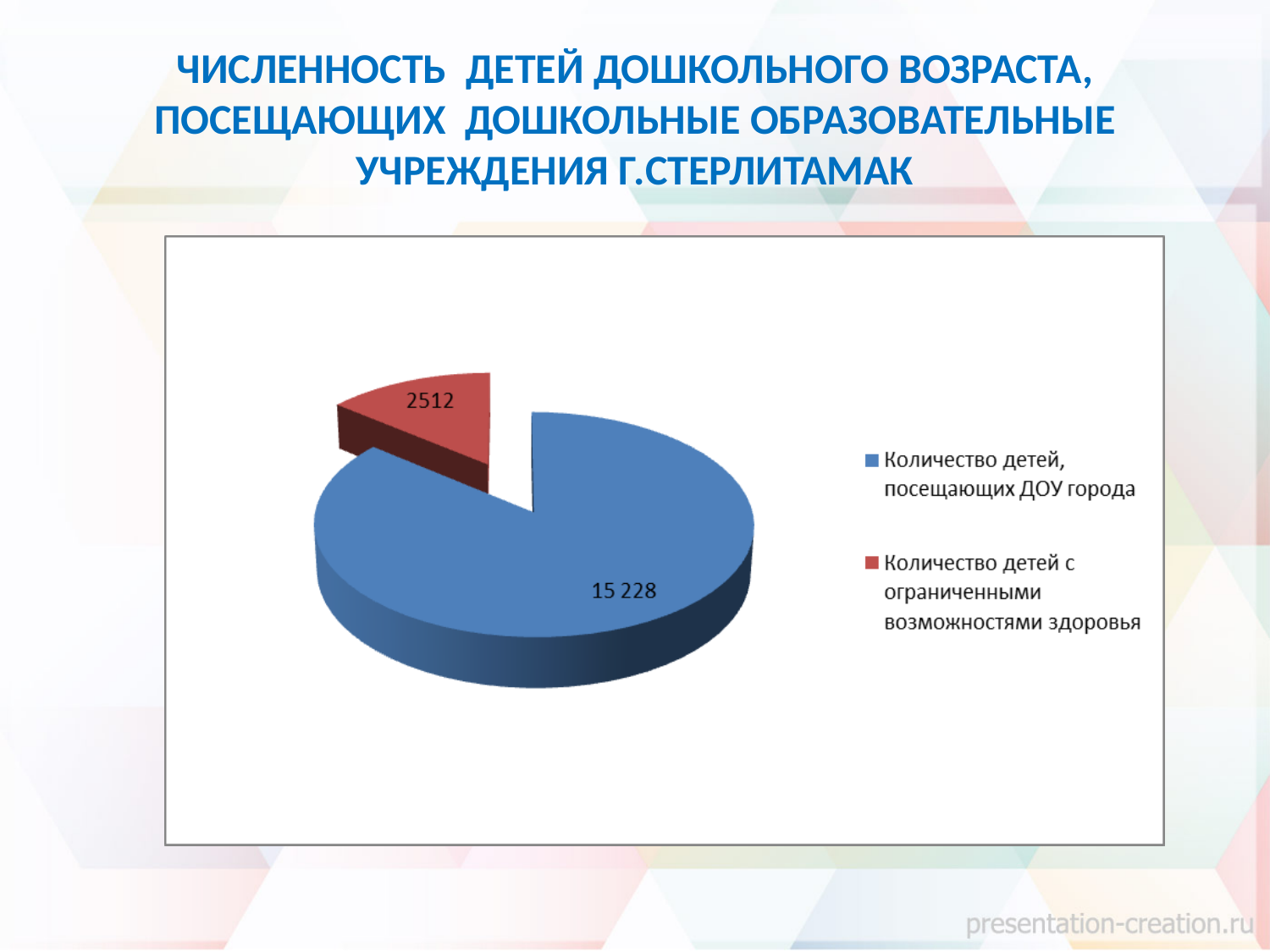
What is the value for "Количество детей с ограниченными возможностями здоровья"? 2512 Which is larger: the value for "Количество детей, посещающих ДОУ города" or the value for "Количество детей с ограниченными возможностями здоровья"? Количество детей, посещающих ДОУ города What is the title of the slide containing the chart? ЧИСЛЕННОСТЬ ДЕТЕЙ ДОШКОЛЬНОГО ВОЗРАСТА, ПОСЕЩАЮЩИХ ДОШКОЛЬНЫЕ ОБРАЗОВАТЕЛЬНЫЕ УЧРЕЖДЕНИЯ Г.СТЕРЛИТАМАК How many entries does the legend list? 2 What colour is the slice for "Количество детей с ограниченными возможностями здоровья"? red What kind of chart is shown on the slide? pie chart What is the value for "Количество детей, посещающих ДОУ города"? 15 228 What is the total of the two values shown in the pie chart? 17740 Which category has the largest slice of the pie? Количество детей, посещающих ДОУ города Which category has the smallest slice of the pie? Количество детей с ограниченными возможностями здоровья How many slices does the pie chart have? 2 What is the difference between the value for "Количество детей, посещающих ДОУ города" and the value for "Количество детей с ограниченными возможностями здоровья"? 12716